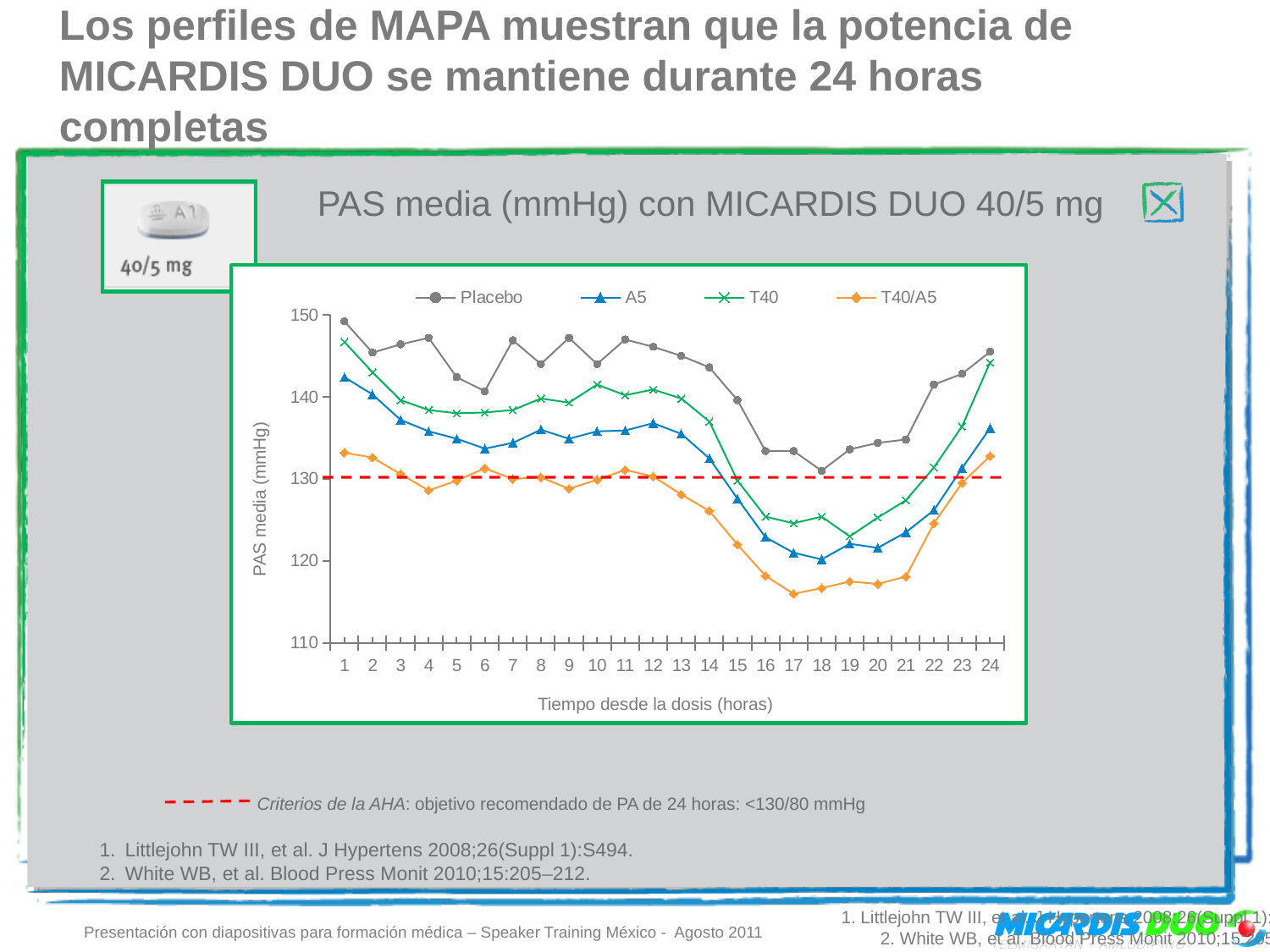
What is the label of the y axis of the chart? PAS media (mmHg) Which series has the lowest PAS media values across the 24 hours? T40/A5 How many series does the legend of the chart list? 4 How many time points (hours) are plotted along the x axis of the chart? 24 Do the T40/A5 values rise or fall from hour 18 to hour 24? rise Which series has the highest PAS media values across the 24 hours? Placebo Is the value for T40/A5 at hour 17 greater or less than 120? less Is the value for A5 at hour 18 greater or less than 130? less At hour 17, which is larger: the value for Placebo or the value for T40/A5? Placebo Is the value for Placebo at hour 1 greater or less than 140? greater What kind of chart is shown on the slide? line chart Do the Placebo values rise or fall from hour 14 to hour 18? fall